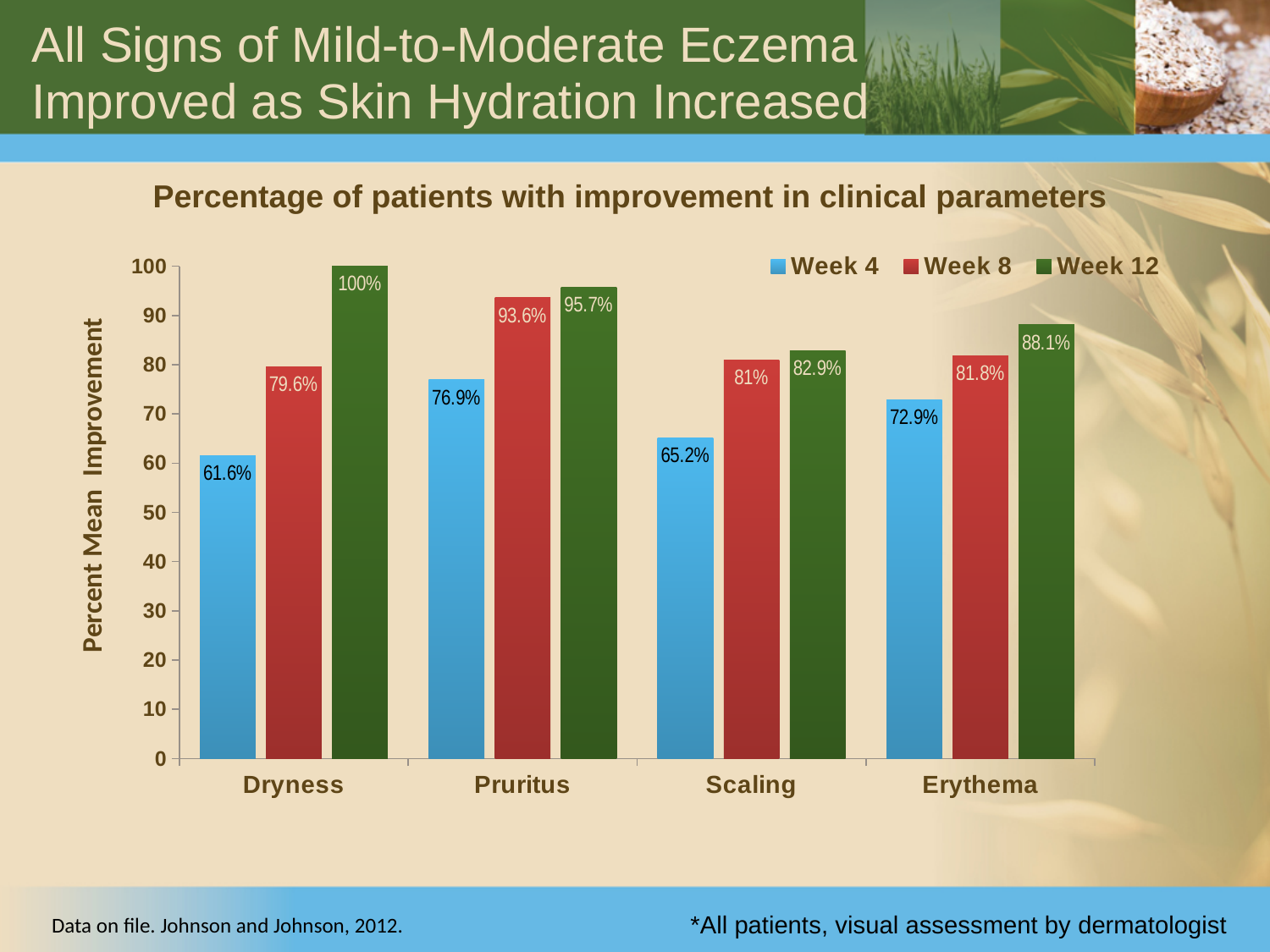
What is the Week 12 value for Erythema? 88.1% What is the difference between the Week 12 and Week 4 values for Dryness? 38.4% What kind of chart is shown on the slide? Bar chart What is the Week 8 value for Scaling? 81% Which clinical parameter has the lowest Week 4 value? Dryness What is the Week 12 value for Pruritus? 95.7% How many series does the legend list? 3 What is the Week 4 value for Dryness? 61.6% How many clinical parameters are shown on the x axis? 4 Which clinical parameter has the highest Week 12 value? Dryness Which is larger, the Week 8 value for Pruritus or the Week 8 value for Erythema? Week 8 value for Pruritus What is the title of the chart? Percentage of patients with improvement in clinical parameters